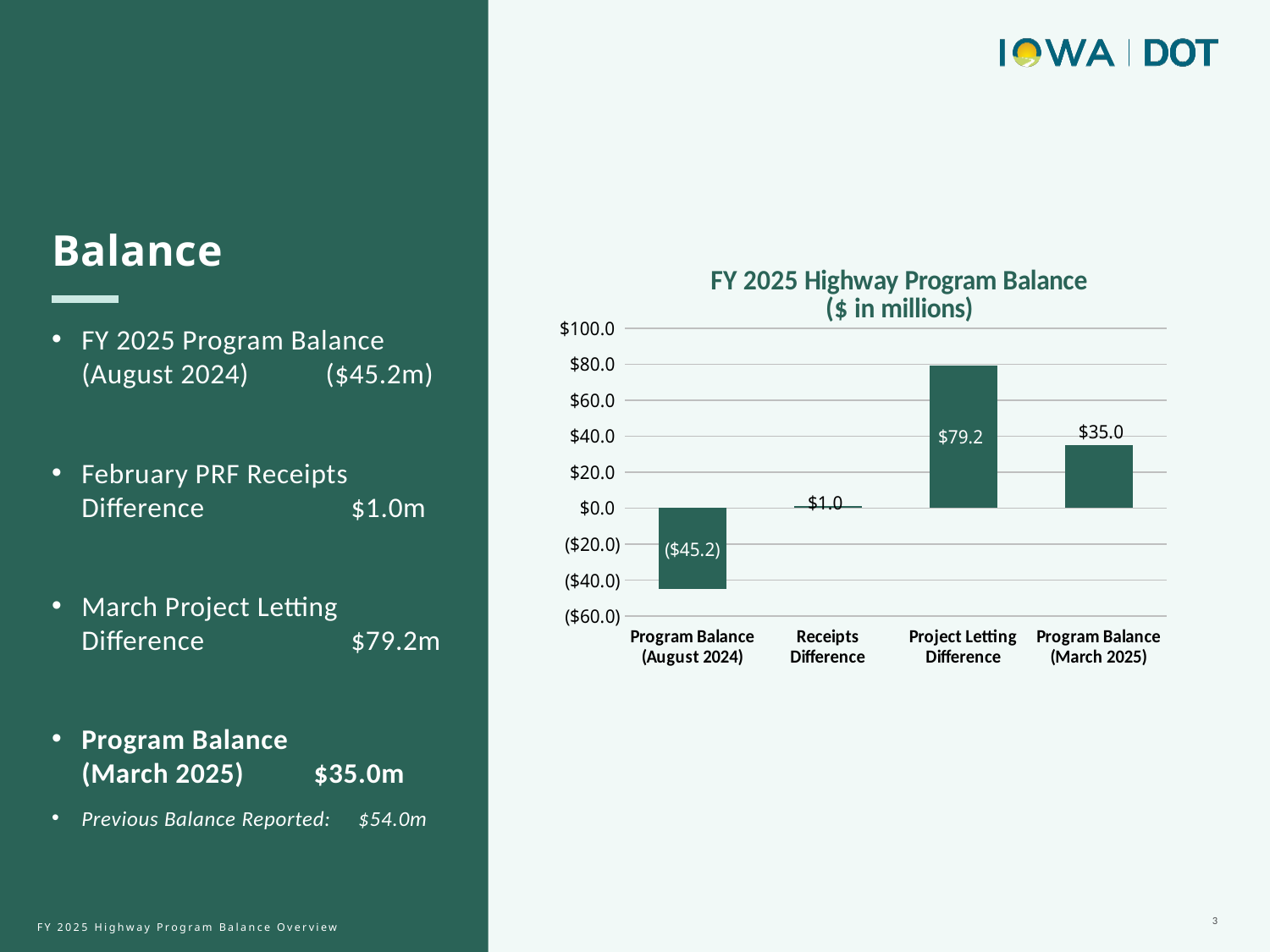
What is the value for Receipts Difference in the chart? $1.0 Is the value for Project Letting Difference greater or less than $60.0? greater How many categories are shown on the x axis of the chart? 4 What is the title of the chart? FY 2025 Highway Program Balance ($ in millions) What is the difference between the Project Letting Difference and the Program Balance (March 2025) values? $44.2 What is the value for Program Balance (March 2025) in the chart? $35.0 Which category has the highest value in the chart? Project Letting Difference What kind of chart is shown on the slide? bar chart What is the value for Program Balance (August 2024) in the FY 2025 Highway Program Balance chart? ($45.2) What is the value for Project Letting Difference in the chart? $79.2 Which is larger, the value for Receipts Difference or the value for Program Balance (March 2025)? Program Balance (March 2025) Which category has the lowest value in the chart? Program Balance (August 2024)